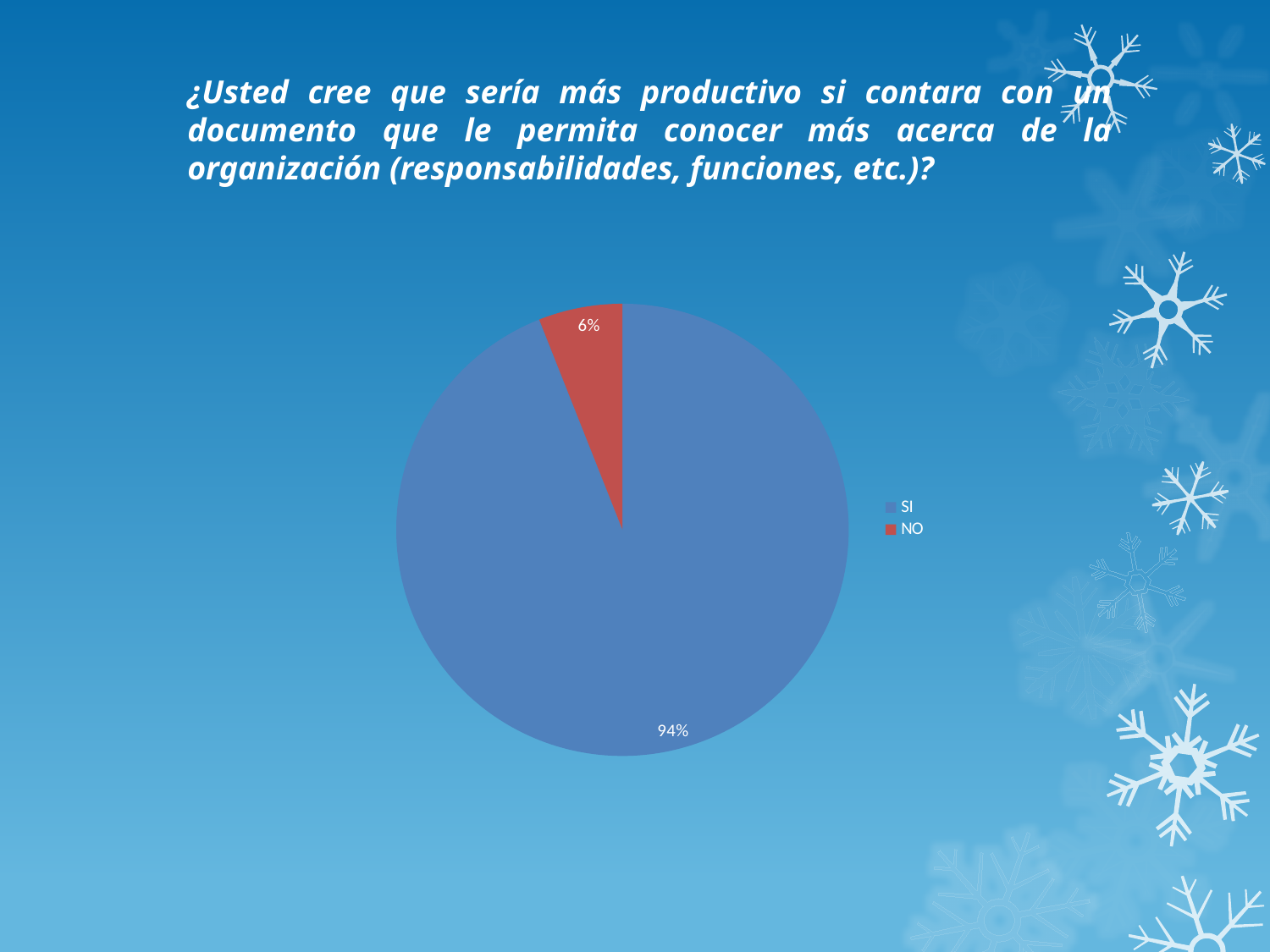
What percentage of the pie is labelled SI? 94% Which is larger, the SI slice or the NO slice? SI Which category has the largest share of the pie? SI How many categories does the pie chart show? 2 How many entries does the legend list? 2 Which category has the smallest share of the pie? NO What colour is the NO slice? red What kind of chart is shown on the slide? pie chart What is the difference in percentage points between the SI and NO slices? 88 What colour is the SI slice? blue What percentage of the pie is labelled NO? 6%